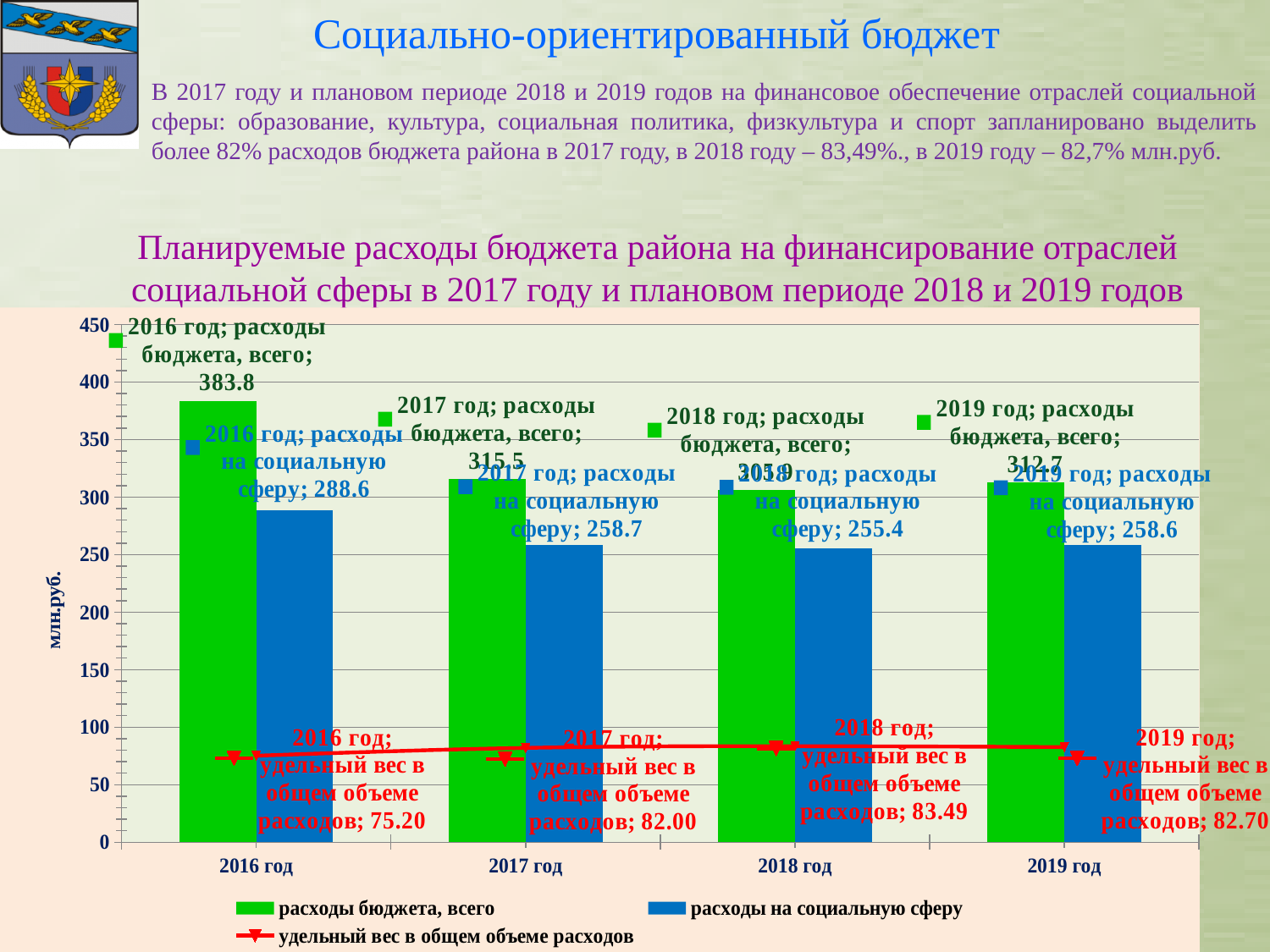
Which year has the lowest value for 'удельный вес в общем объеме расходов'? 2016 год Which year has the highest value for 'расходы бюджета, всего'? 2016 год How many series does the chart legend list? 3 What is the value of 'расходы на социальную сферу' for 2019 год? 258.6 What is the value of 'расходы на социальную сферу' for 2017 год? 258.7 Is the value of 'расходы бюджета, всего' for 2018 год greater or less than 350? less How many years are shown on the x axis of the chart? 4 What is the unit shown on the vertical axis of the chart? млн.руб. What is the value of 'удельный вес в общем объеме расходов' for 2018 год? 83.49 Which is larger: 'расходы на социальную сферу' in 2016 год or in 2018 год? 2016 год What is the value of 'расходы бюджета, всего' for 2016 год? 383.8 What is the difference between 'расходы бюджета, всего' and 'расходы на социальную сферу' in 2016 год? 95.2